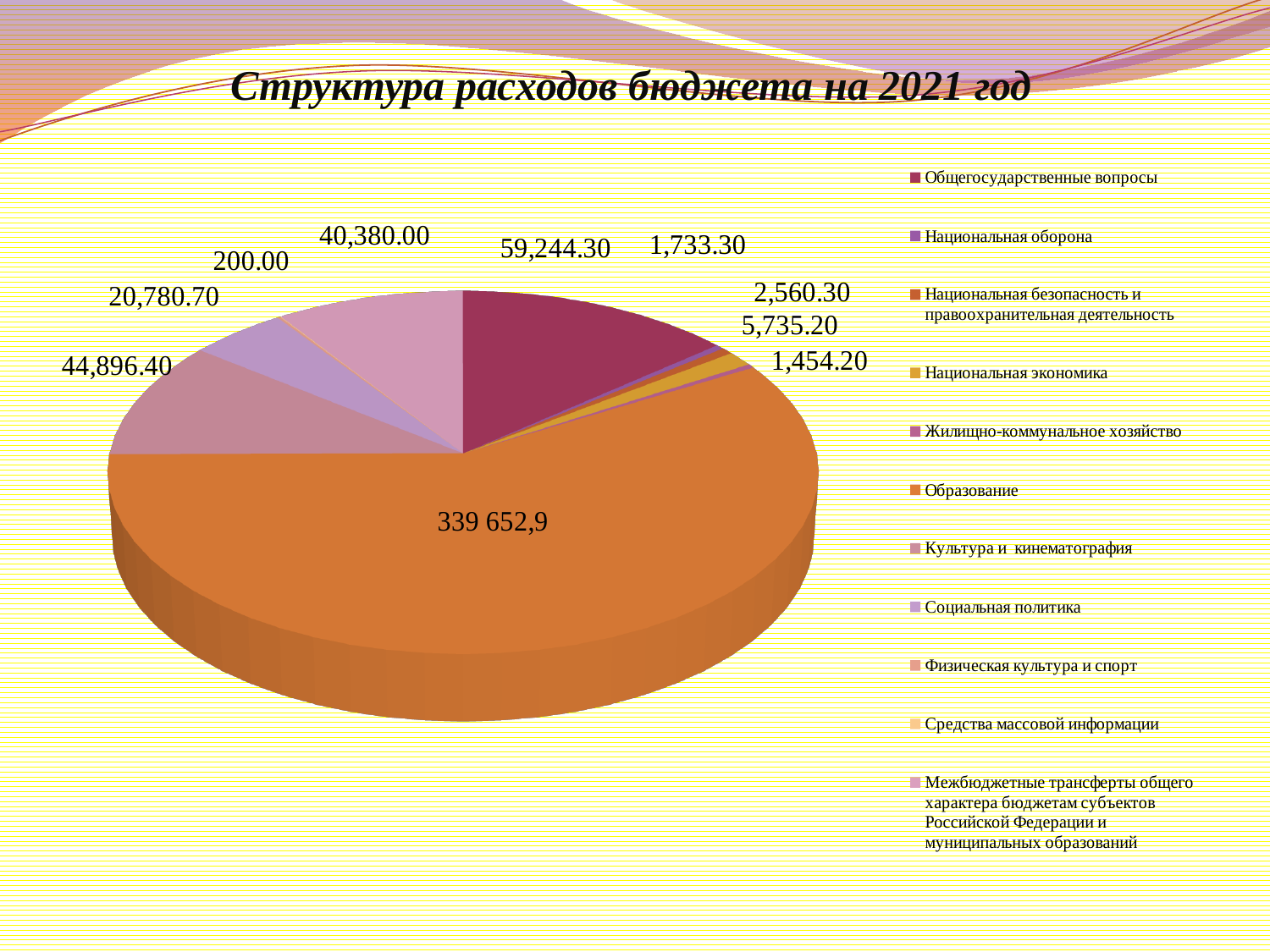
Which category has the largest slice of the pie? Образование What is the difference between the values for Культура и кинематография and Социальная политика? 24,115.70 Which is larger, the value for Общегосударственные вопросы or the value for Культура и кинематография? Общегосударственные вопросы What is the value shown for Социальная политика? 20,780.70 What is the value shown for Общегосударственные вопросы? 59,244.30 What is the difference between the values for Общегосударственные вопросы and Культура и кинематография? 14,347.90 What type of chart is shown on the slide? Pie chart What is the value shown for Культура и кинематография? 44,896.40 What is the title of the chart? Структура расходов бюджета на 2021 год What is the smallest value labelled on the pie chart? 200.00 How many entries does the chart legend list? 11 What is the value shown for Образование? 339 652,9